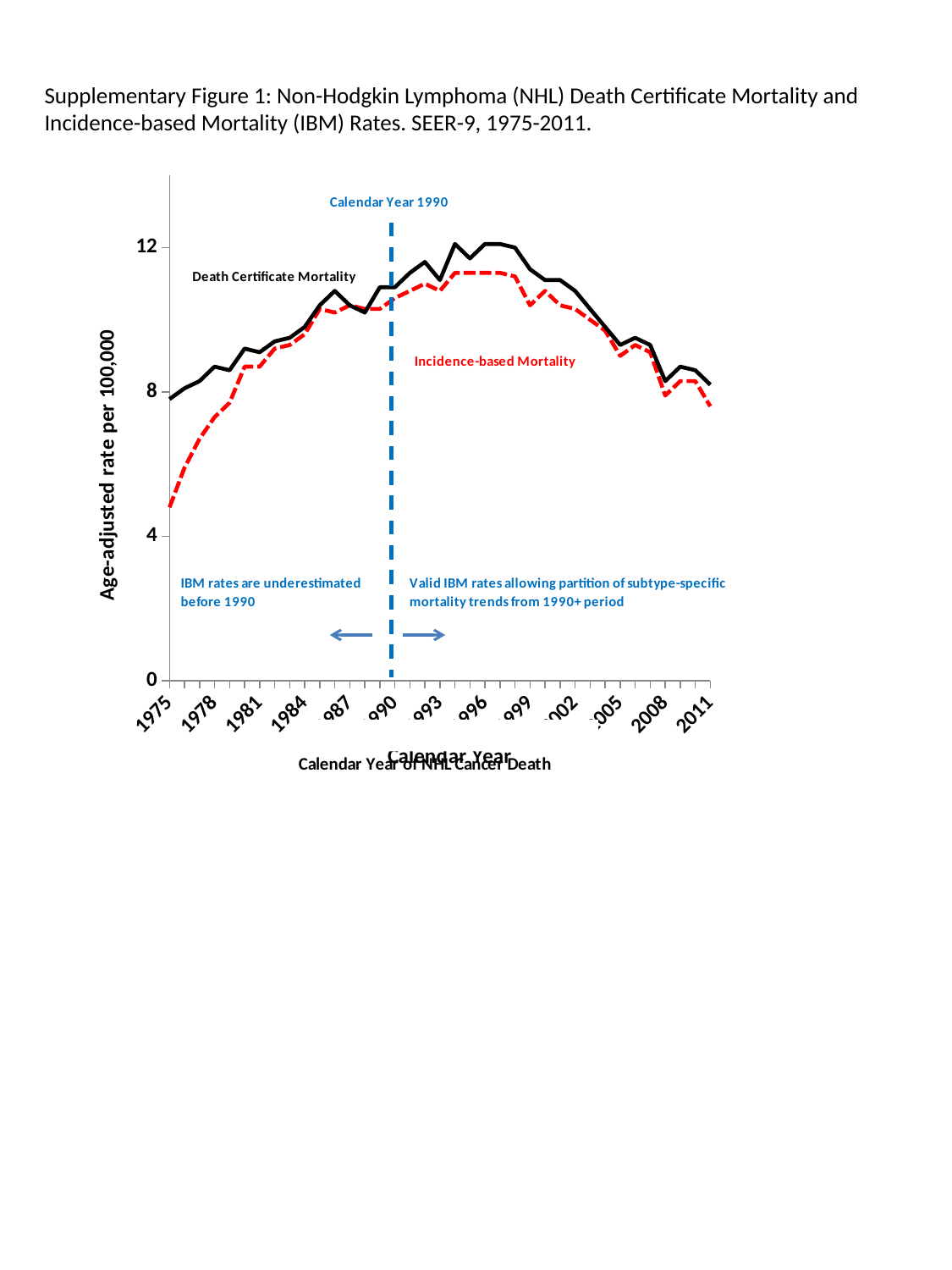
What kind of chart is shown on the slide? Line chart Is the Incidence-based Mortality value in 2011 greater or less than 4? greater How many year labels are shown on the x axis? 13 Is the Incidence-based Mortality value in 1975 greater or less than 4? greater Is the Death Certificate Mortality value in 1975 greater or less than 12? less How many data series are plotted on the chart? 2 Does the Incidence-based Mortality series rise or fall between 1999 and 2011? Fall Which two series are plotted on the chart? Death Certificate Mortality and Incidence-based Mortality Does the Death Certificate Mortality series rise or fall between 1975 and 1990? Rise At which calendar year is the vertical dashed line drawn? 1990 In 1975, which series has the higher value, Death Certificate Mortality or Incidence-based Mortality? Death Certificate Mortality